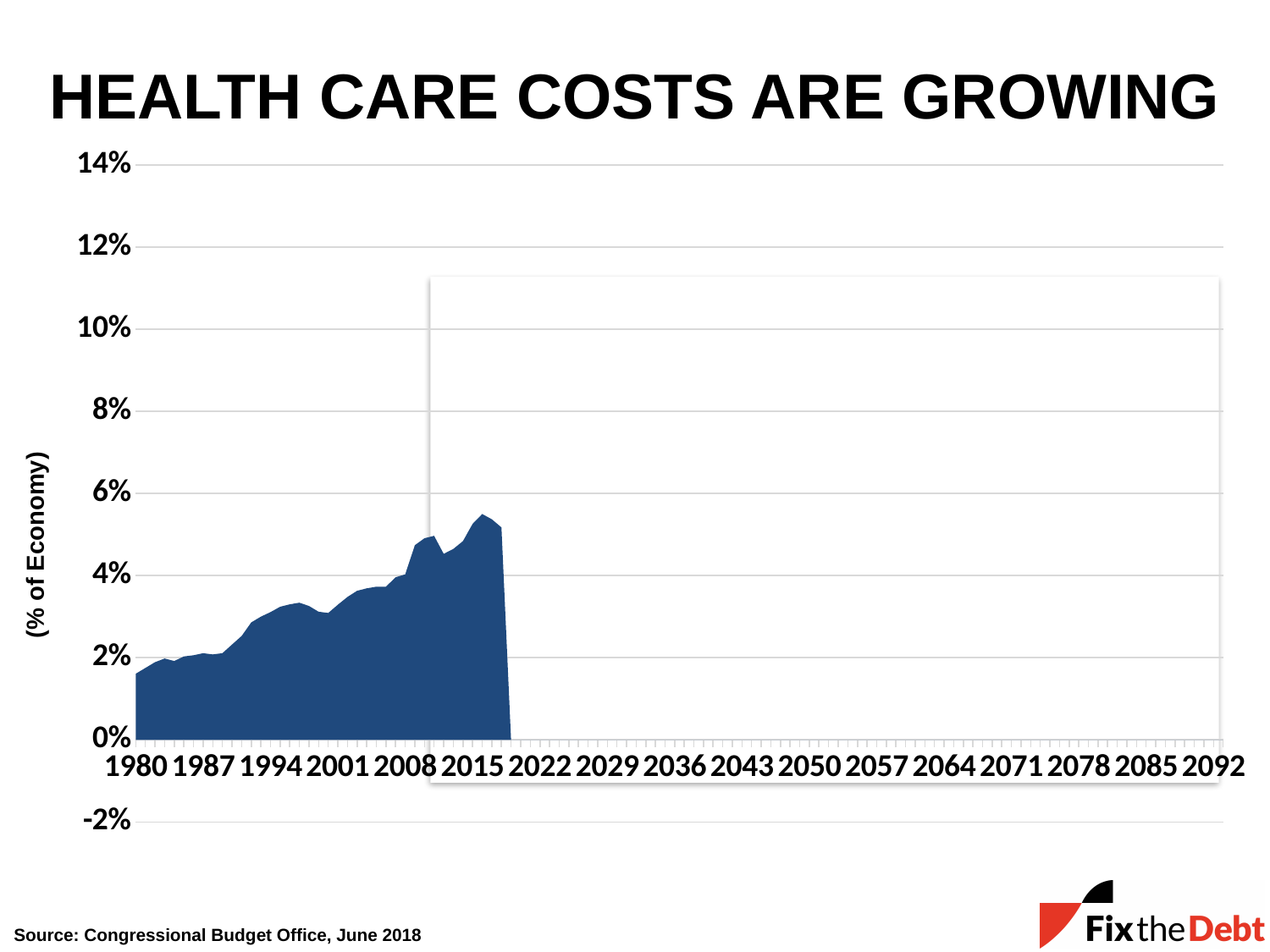
What kind of chart is shown on the slide? area chart Is the value for 2015 greater or less than 6%? less Which year has a lower value, 1987 or 2008? 1987 Is the value for 1994 greater or less than 4%? less Is the value for 2001 greater or less than 2%? greater What is the label on the vertical axis of the chart? (% of Economy) Which year has a higher value, 1980 or 2015? 2015 What is the title of the chart? HEALTH CARE COSTS ARE GROWING Do health care costs as a share of the economy generally rise or fall from 1980 to 2015? rise